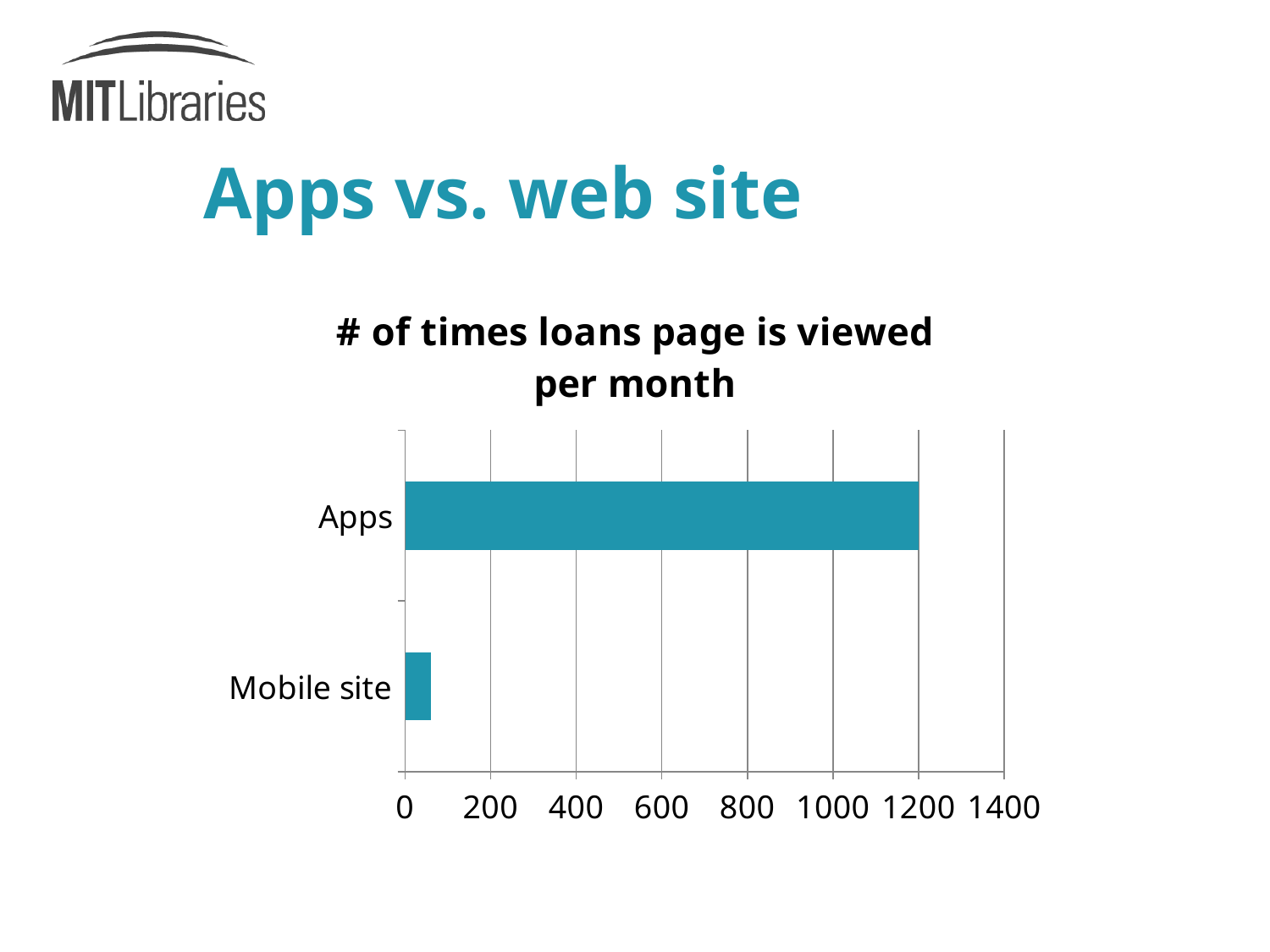
What is the value for Apps? 1200 Which category has the highest value? Apps Which category has the lowest value? Mobile site What is the title of the chart? # of times loans page is viewed per month Which is larger, the value for Apps or the value for Mobile site? Apps Is the value for Mobile site greater or less than 200? less What is the maximum value shown on the horizontal axis? 1400 What kind of chart is shown on the slide? bar chart Is the value for Apps greater or less than 1000? greater How many categories are plotted in the chart? 2